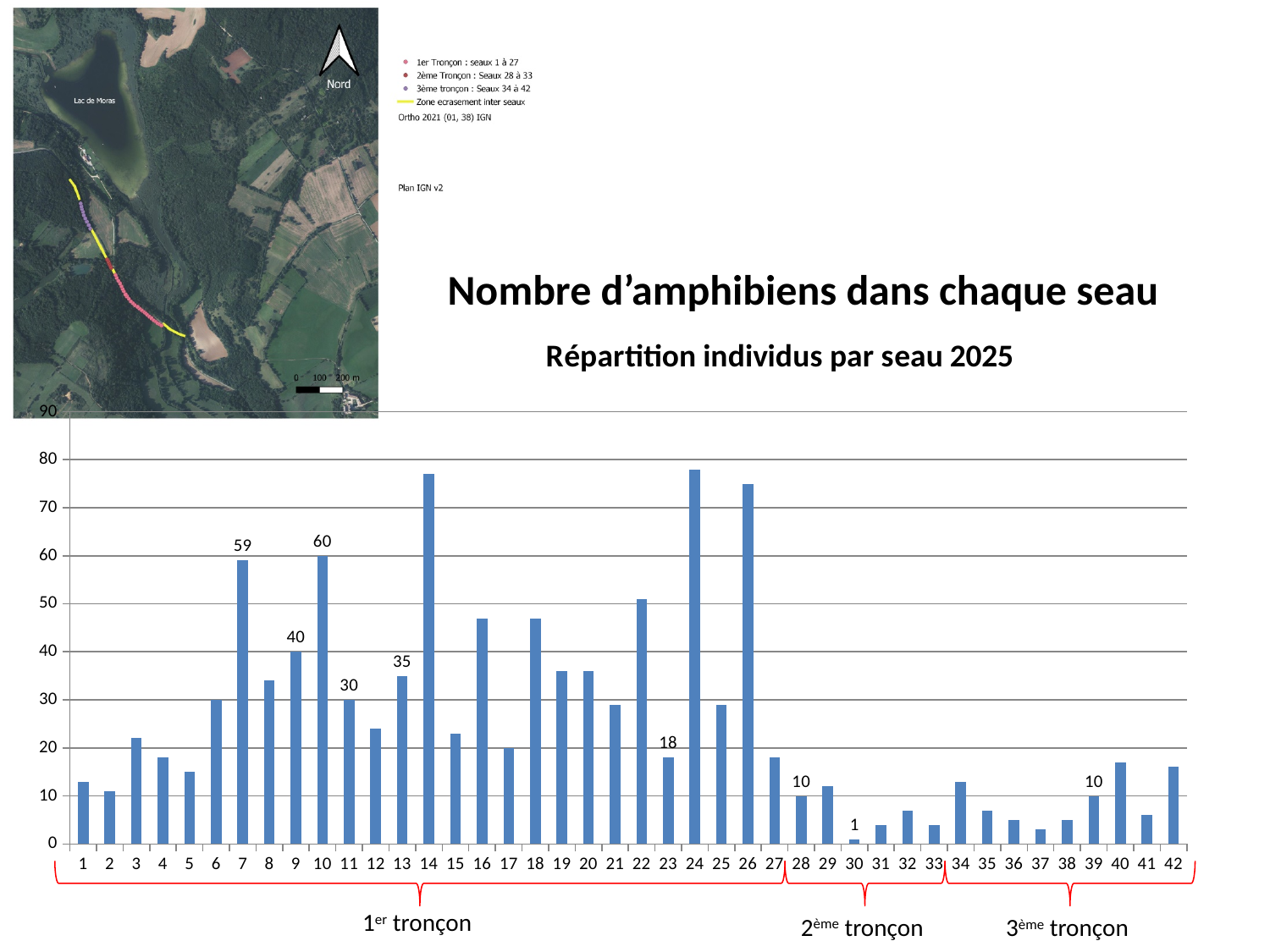
Is the value for bucket 37 greater or less than 10? less What type of chart is shown on the slide? Bar chart Which has a larger value, bucket 10 or bucket 7? Bucket 10 What is the value for bucket 7? 59 Is the value for bucket 24 greater or less than 70? greater What is the difference between the values for bucket 13 and bucket 23? 17 What is the title of the chart? Répartition individus par seau 2025 Which bucket has the lowest value? 30 How many buckets (seaux) are shown on the x axis of the chart? 42 What is the value for bucket 30? 1 What is the difference between the values for bucket 9 and bucket 11? 10 What is the value for bucket 10? 60